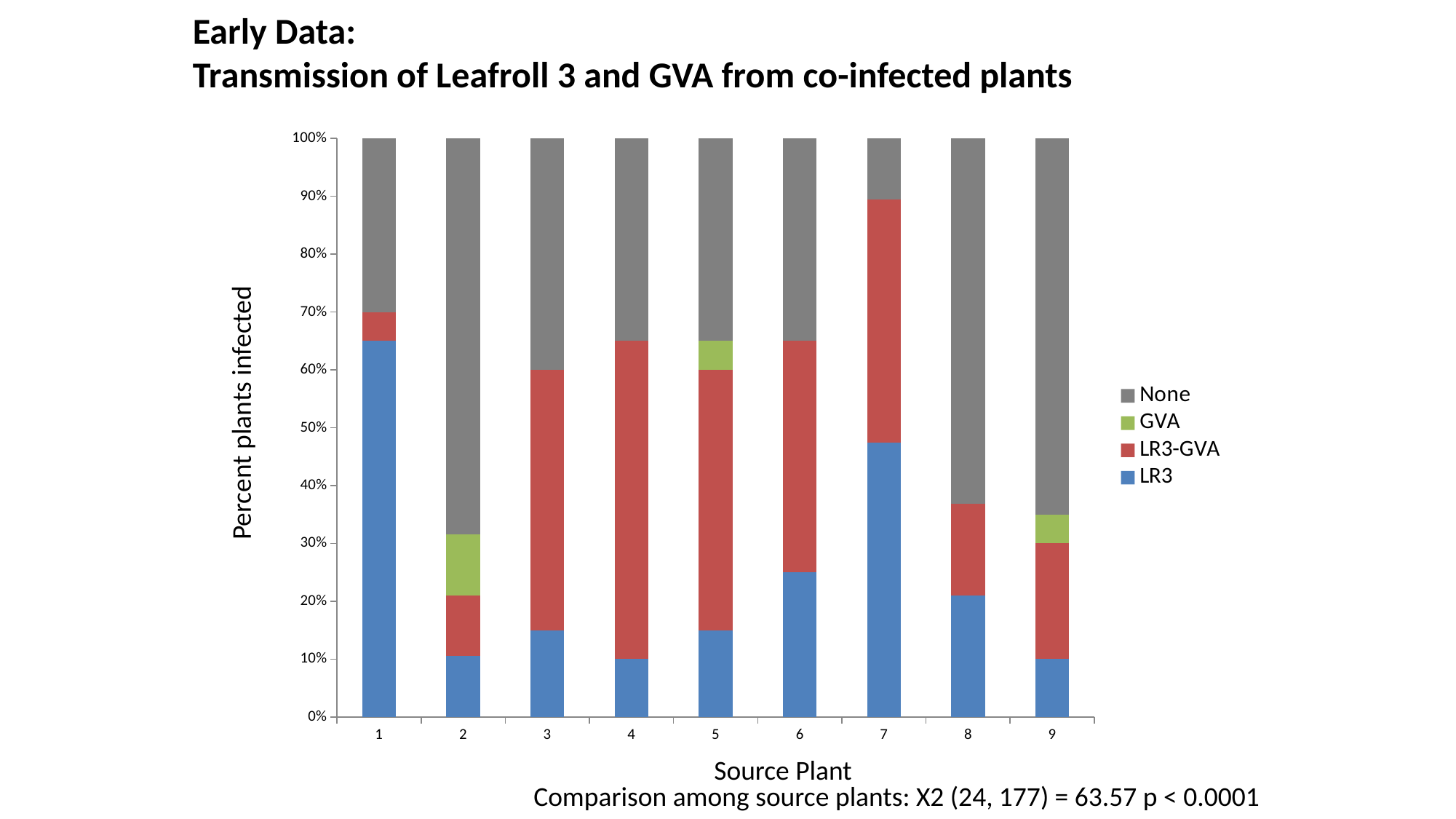
Which source plant has the largest LR3 segment? 1 How many source plants are shown on the x axis? 9 Which has the larger LR3 segment, source plant 7 or source plant 6? Source plant 7 What is the title of the y axis? Percent plants infected Is the LR3 share for source plant 1 greater or less than 60%? greater Is the None share for source plant 7 greater or less than 20%? less How many series does the legend list? 4 How many source plants show a GVA segment? 3 Which source plant has the largest LR3-GVA segment? 4 What kind of chart is shown on the slide? Stacked bar chart Which source plant has the smallest None segment? 7 Is the None share for source plant 2 greater or less than 60%? greater